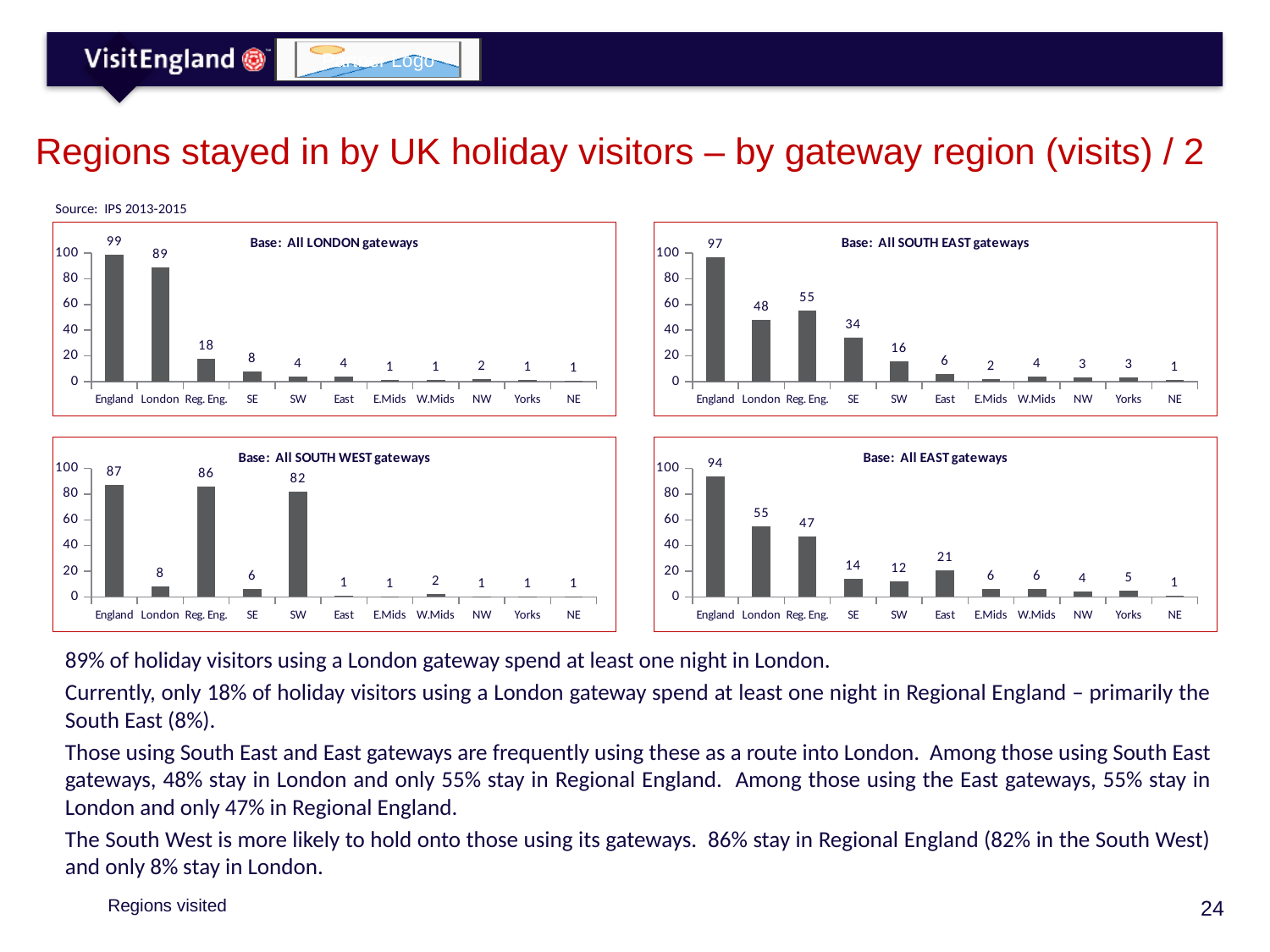
What type of chart is the 'Base: All SOUTH WEST gateways' chart? Bar chart In the 'Base: All SOUTH EAST gateways' chart, what is the value for Reg. Eng.? 55 In the 'Base: All LONDON gateways' chart, what is the difference between the values for England and Reg. Eng.? 81 How many charts are shown on the slide? 4 In the 'Base: All SOUTH EAST gateways' chart, is the value for SE greater or less than 20? greater In the 'Base: All EAST gateways' chart, which category has the highest value? England In the 'Base: All SOUTH EAST gateways' chart, which is larger, the value for London or the value for Reg. Eng.? Reg. Eng. In the 'Base: All EAST gateways' chart, what is the value for East? 21 In the 'Base: All LONDON gateways' chart, what is the value for London? 89 In the 'Base: All SOUTH WEST gateways' chart, what is the difference between the values for Reg. Eng. and London? 78 How many categories are shown on the x axis of the 'Base: All EAST gateways' chart? 11 In the 'Base: All SOUTH WEST gateways' chart, what is the value for SW? 82